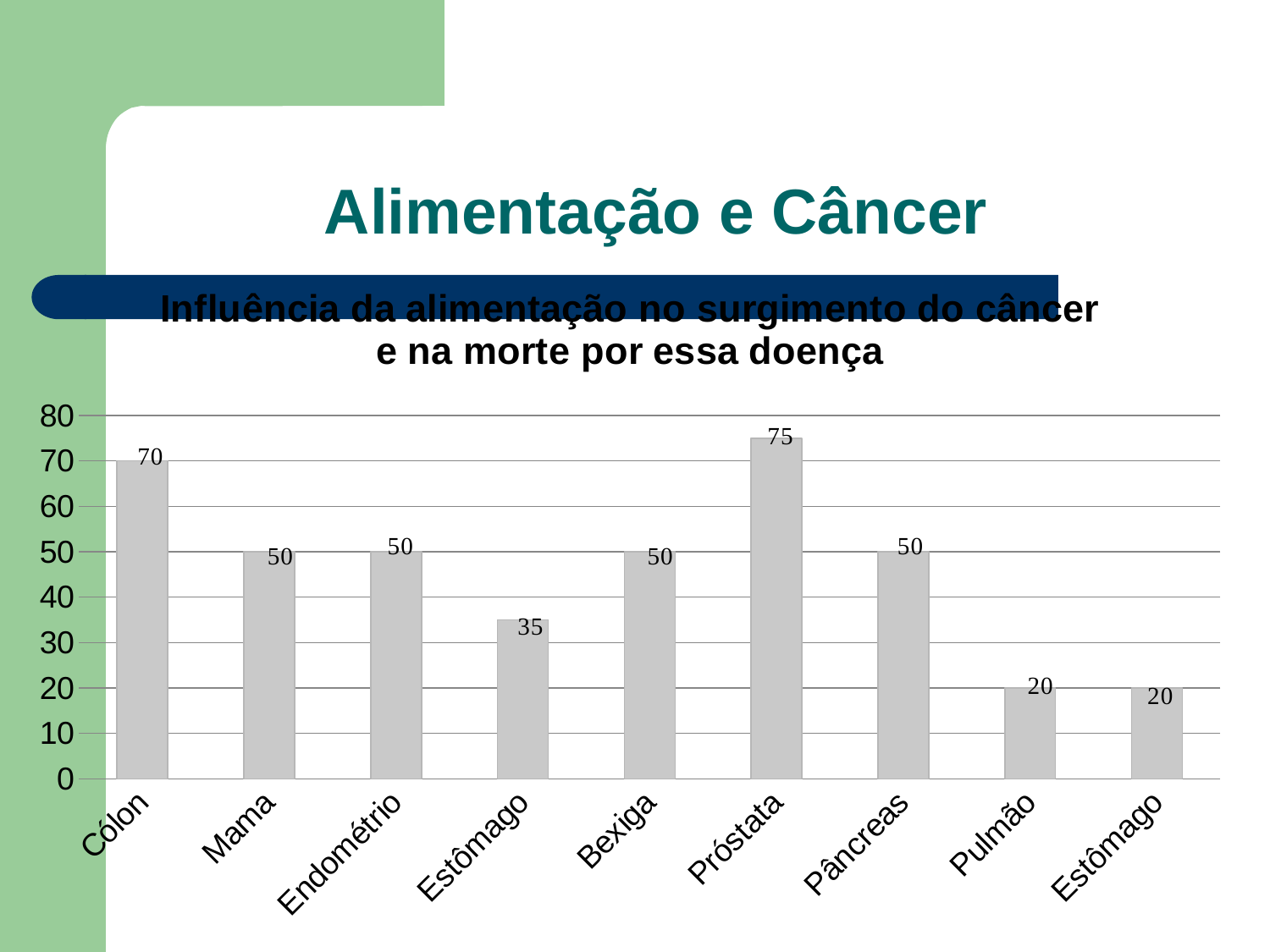
What is the difference between the values for Cólon and Pulmão? 50 What is the value for Próstata? 75 What is the value for Pulmão? 20 Is the value for Pâncreas greater or less than 40? greater What is the value for Mama? 50 What is the difference between the values for Próstata and Cólon? 5 Which category has the highest value? Próstata What is the value for Bexiga? 50 Which is larger, the value for Cólon or the value for Mama? Cólon How many categories are shown on the x axis? 9 What is the value for Cólon? 70 What type of chart is shown on the slide? bar chart